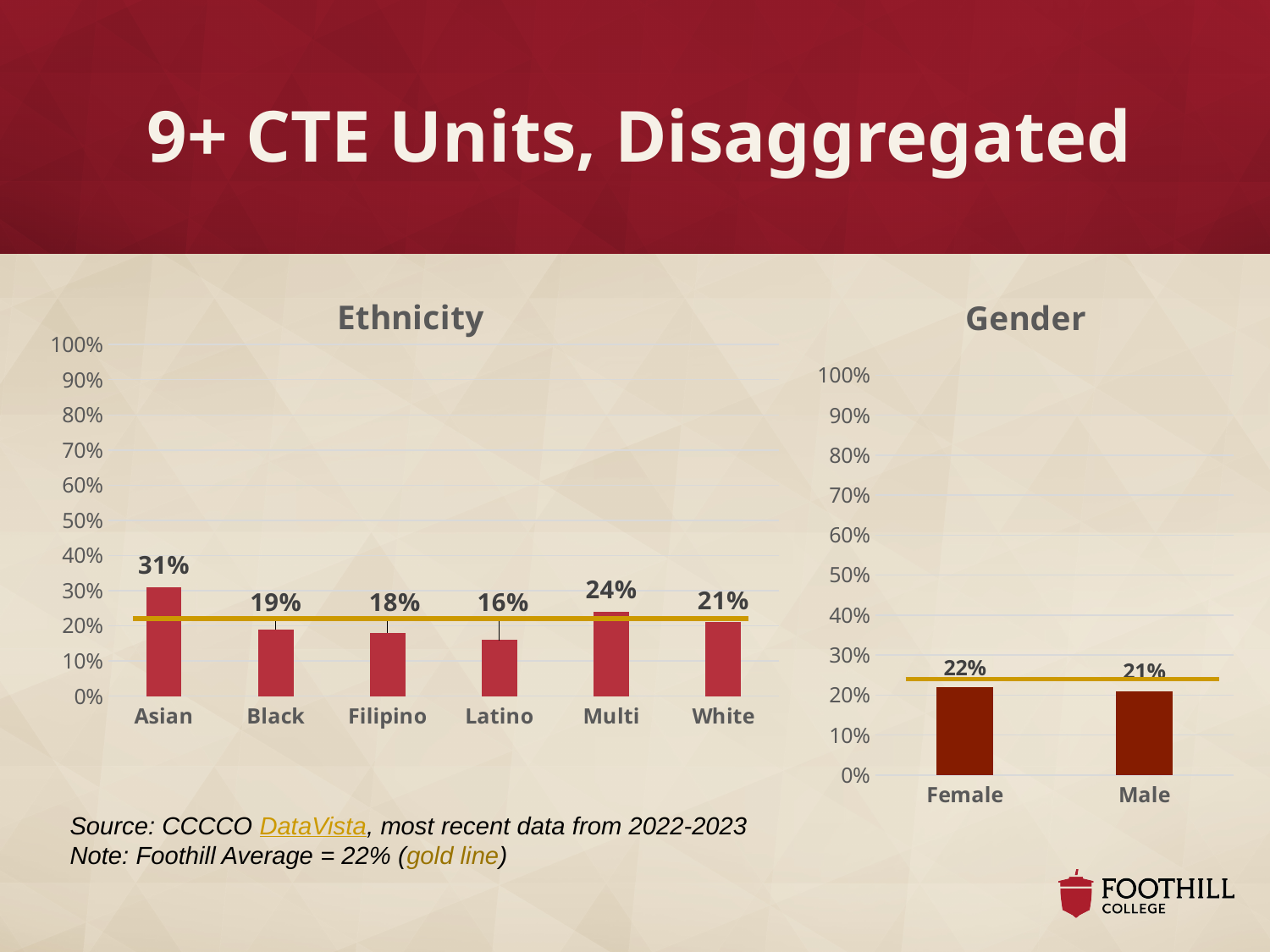
In the Ethnicity chart, what is the value for Latino? 16% In the Ethnicity chart, which is larger, the value for Black or the value for White? White In the Ethnicity chart, what is the value for Asian? 31% In the Ethnicity chart, which category has the lowest value? Latino In the Ethnicity chart, what is the difference between the values for Asian and Multi? 7% According to the note on the slide, what does the gold line in the charts represent? Foothill Average = 22% In the Ethnicity chart, how many categories are shown on the x axis? 6 In the Gender chart, what is the difference between the Female and Male values? 1% In the Gender chart, what is the value for Male? 21% In the Ethnicity chart, which category has the highest value? Asian In the Gender chart, what is the value for Female? 22% What kind of chart is the Gender chart? Bar chart